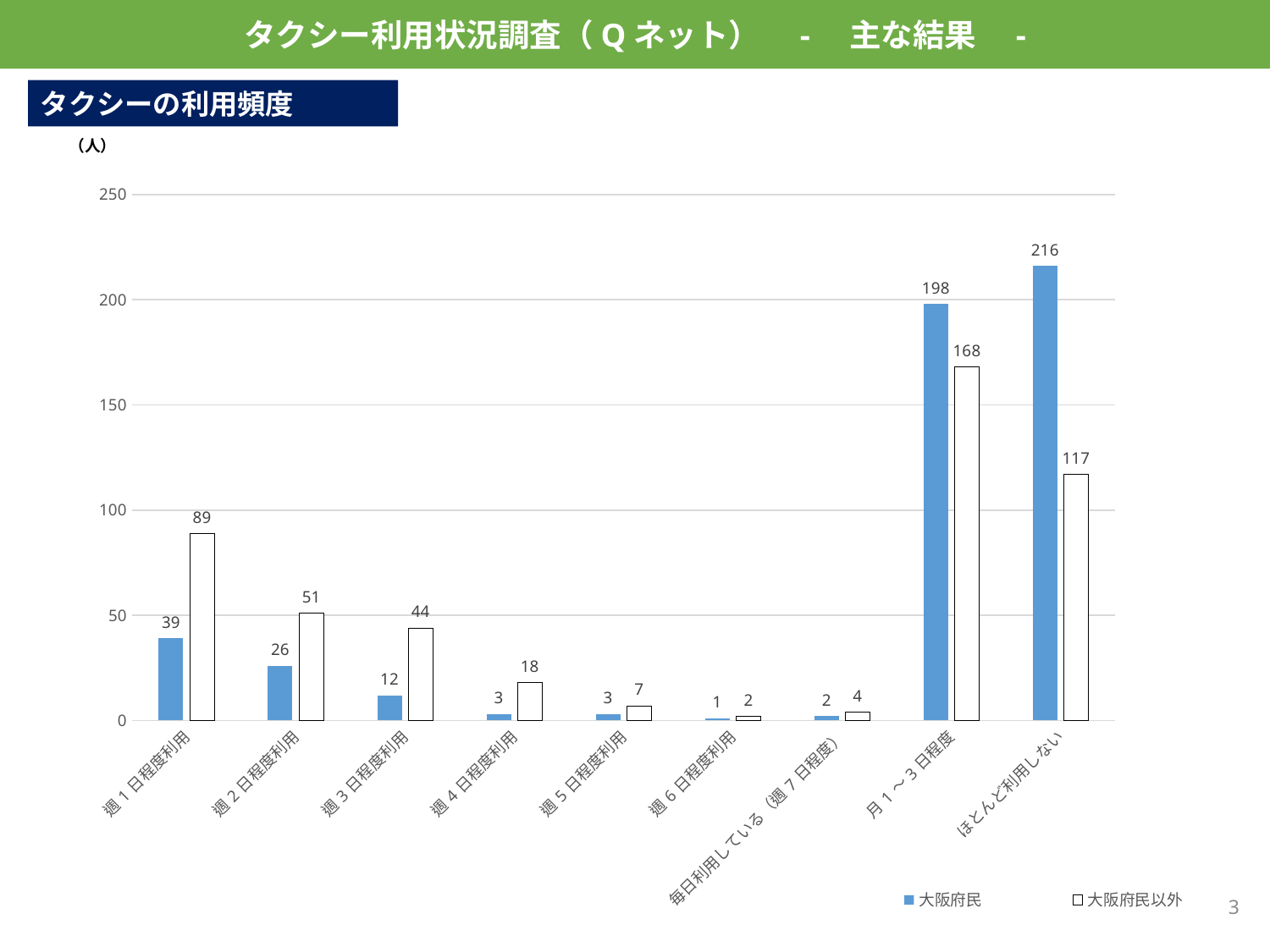
How many series does the legend list? 2 What is the value for 大阪府民 in the 週１日程度利用 category? 39 What unit is indicated above the y axis of the chart? （人） In the 週２日程度利用 category, which series has the larger value, 大阪府民 or 大阪府民以外? 大阪府民以外 Which category has the highest value for 大阪府民? ほとんど利用しない How many categories are shown on the x axis? 9 What kind of chart is shown on the slide? bar chart Which category has the lowest value for 大阪府民? 週６日程度利用 What is the difference between 大阪府民 and 大阪府民以外 in the ほとんど利用しない category? 99 What is the value for 大阪府民以外 in the 週３日程度利用 category? 44 What is the value for 大阪府民以外 in the 月１～３日程度 category? 168 Which category has the highest value for 大阪府民以外? 月１～３日程度